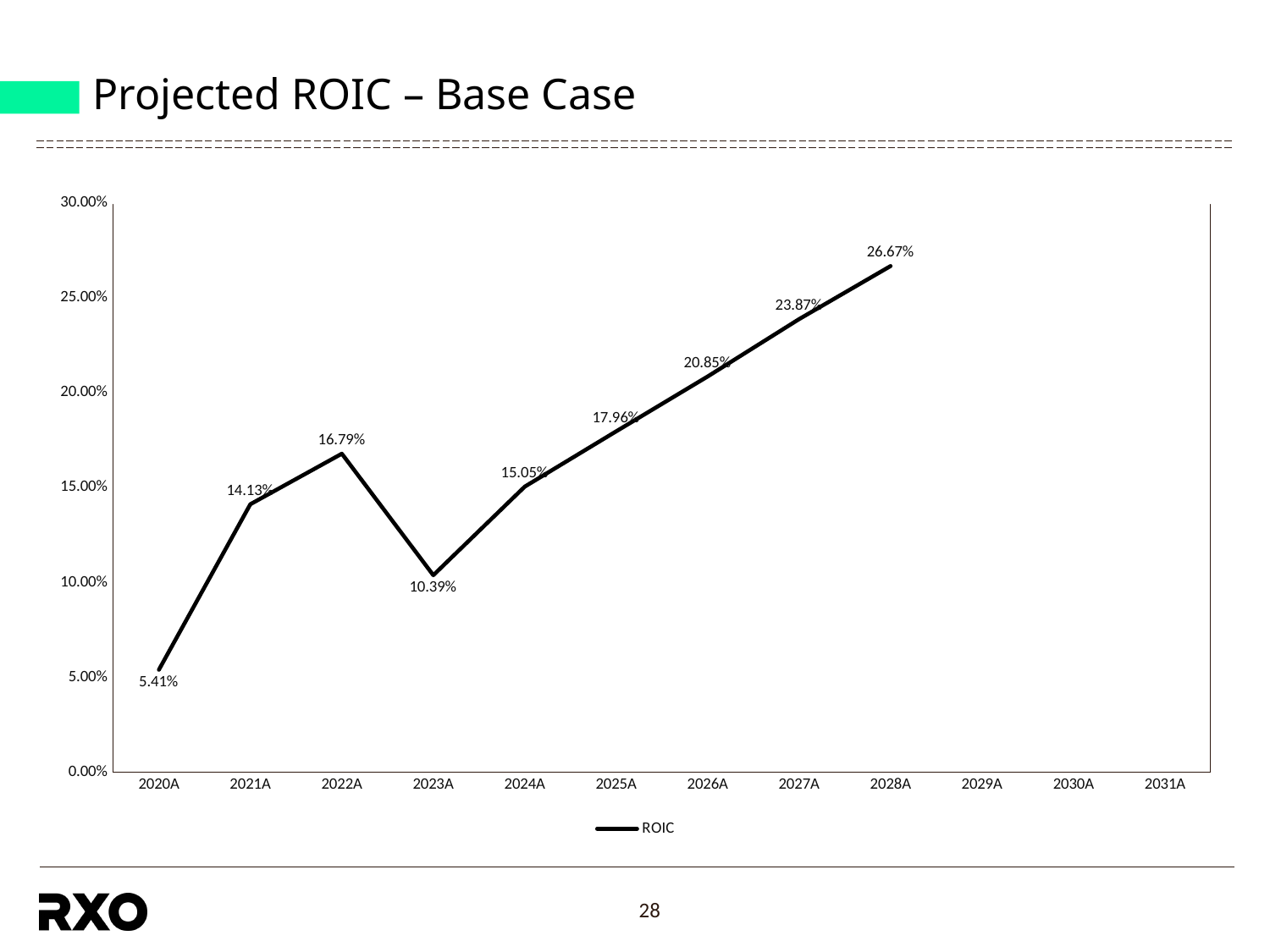
Which year has the highest ROIC value? 2028A What is the difference between the ROIC values for 2028A and 2020A? 21.26% What is the title of the slide? Projected ROIC – Base Case Which is larger, the ROIC value for 2022A or for 2024A? 2022A How many data points are plotted with labels on the ROIC line? 9 Which year has the lowest ROIC value? 2020A What is the difference between the ROIC values for 2022A and 2023A? 6.40% What is the ROIC value for 2020A? 5.41% What kind of chart is shown on the slide? line chart What is the ROIC value for 2023A? 10.39% What is the ROIC value for 2028A? 26.67% Is the ROIC value for 2027A greater or less than 25.00%? less